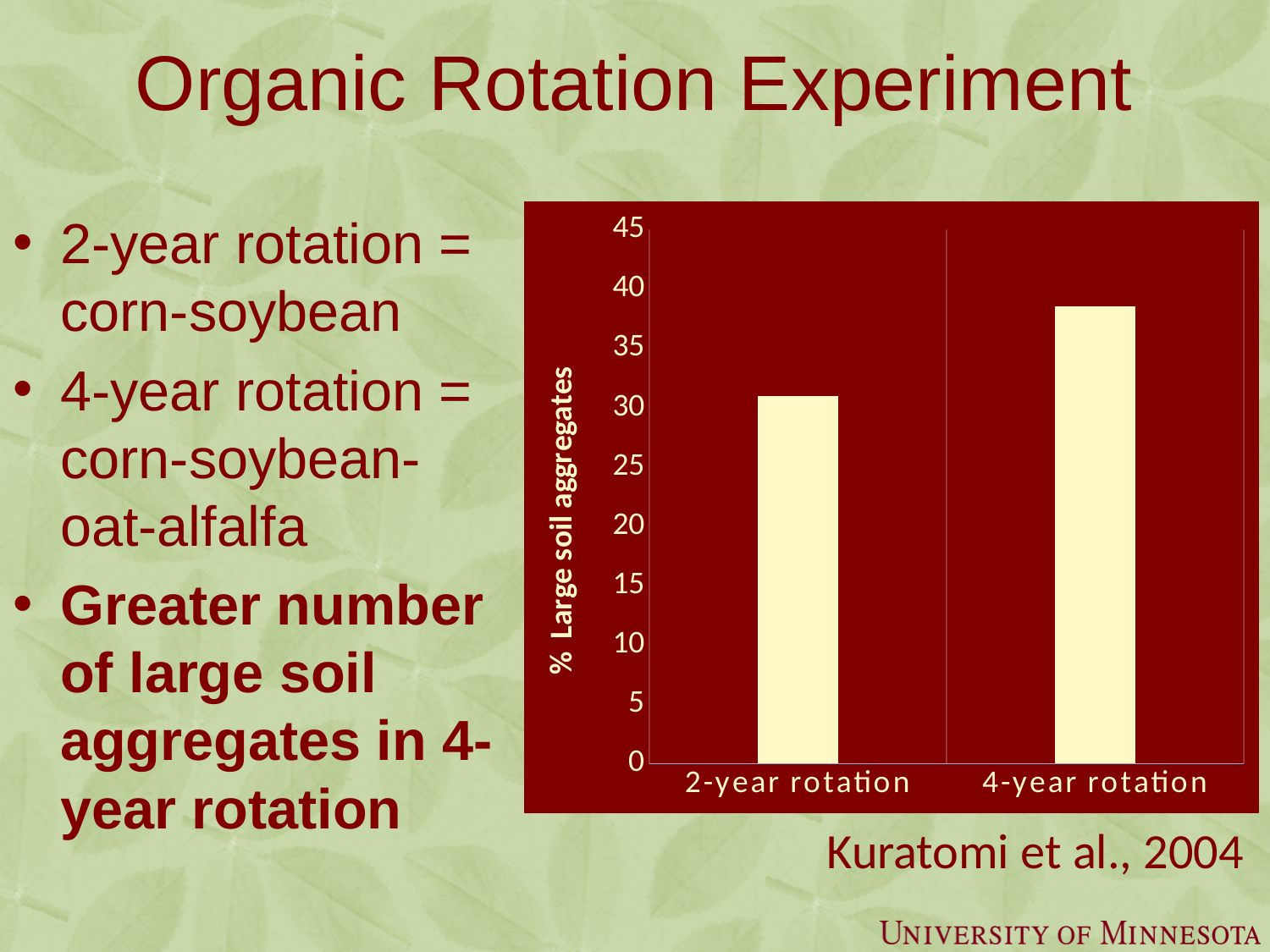
What kind of chart is shown on the slide? bar chart What is the label on the y axis of the chart? % Large soil aggregates Do the values rise or fall from 2-year rotation to 4-year rotation along the x axis? rise How many categories are plotted on the x axis of the chart? 2 Which rotation has the highest % large soil aggregates in the chart? 4-year rotation Is the value for 2-year rotation greater or less than 25? greater Is the value for 4-year rotation greater or less than 40? less What is the maximum value shown on the y axis of the chart? 45 Which is larger in the chart, the value for 2-year rotation or the value for 4-year rotation? 4-year rotation Is the value for 4-year rotation greater or less than 35? greater Which rotation has the lowest % large soil aggregates in the chart? 2-year rotation